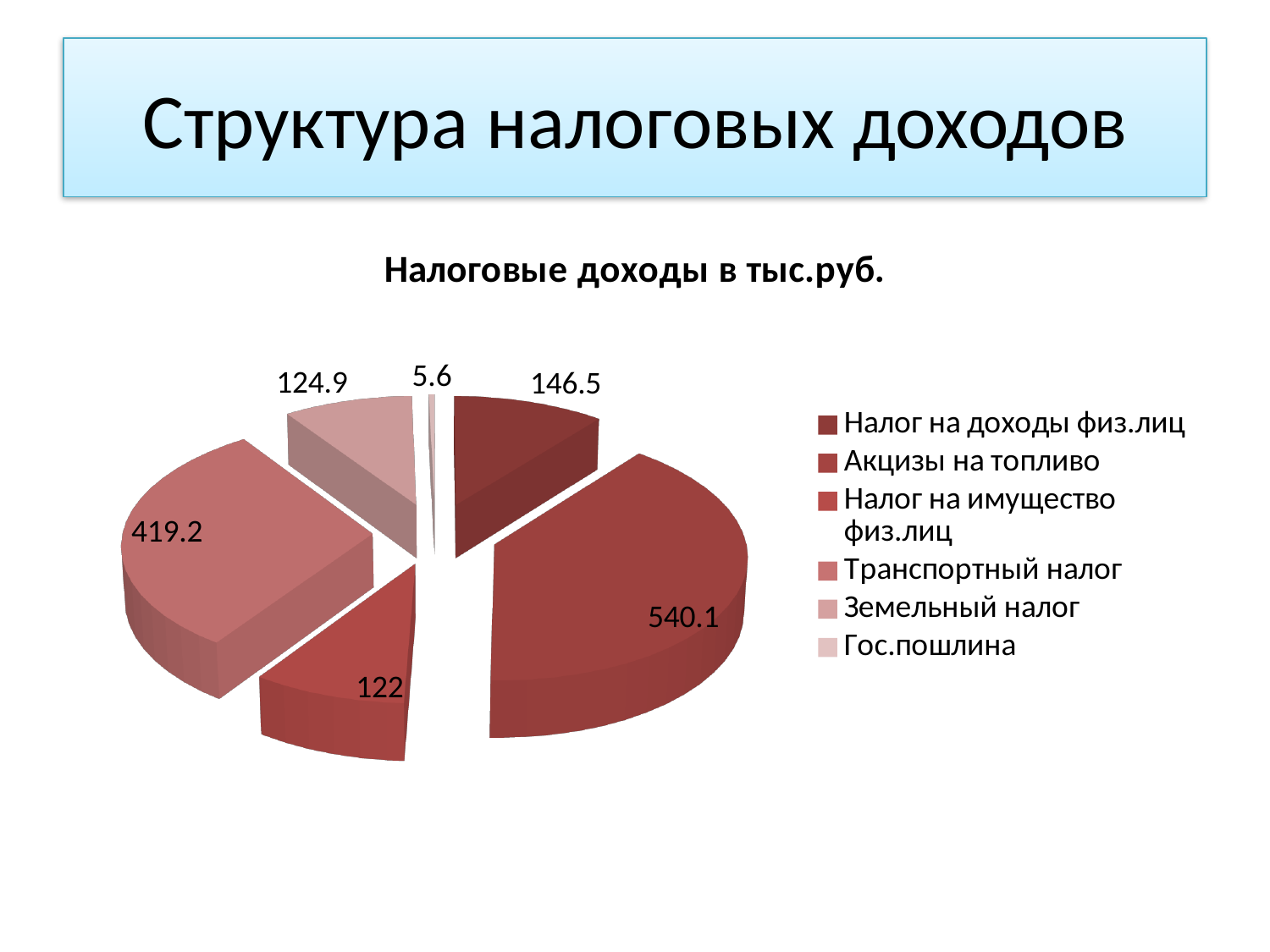
What is the value for Гос.пошлина? 5.6 Which category has the smallest value? Гос.пошлина Which is larger, Налог на доходы физ.лиц or Земельный налог? Налог на доходы физ.лиц What is the value for Транспортный налог? 419.2 What is the value for Налог на имущество физ.лиц? 122 What is the value for Акцизы на топливо? 540.1 What is the difference between Акцизы на топливо and Транспортный налог? 120.9 Which category has the largest value? Акцизы на топливо What type of chart is shown on the slide? Pie chart What is the title of the chart? Налоговые доходы в тыс.руб. What is the total of all the slices in the pie? 1358.3 How many categories does the legend list? 6